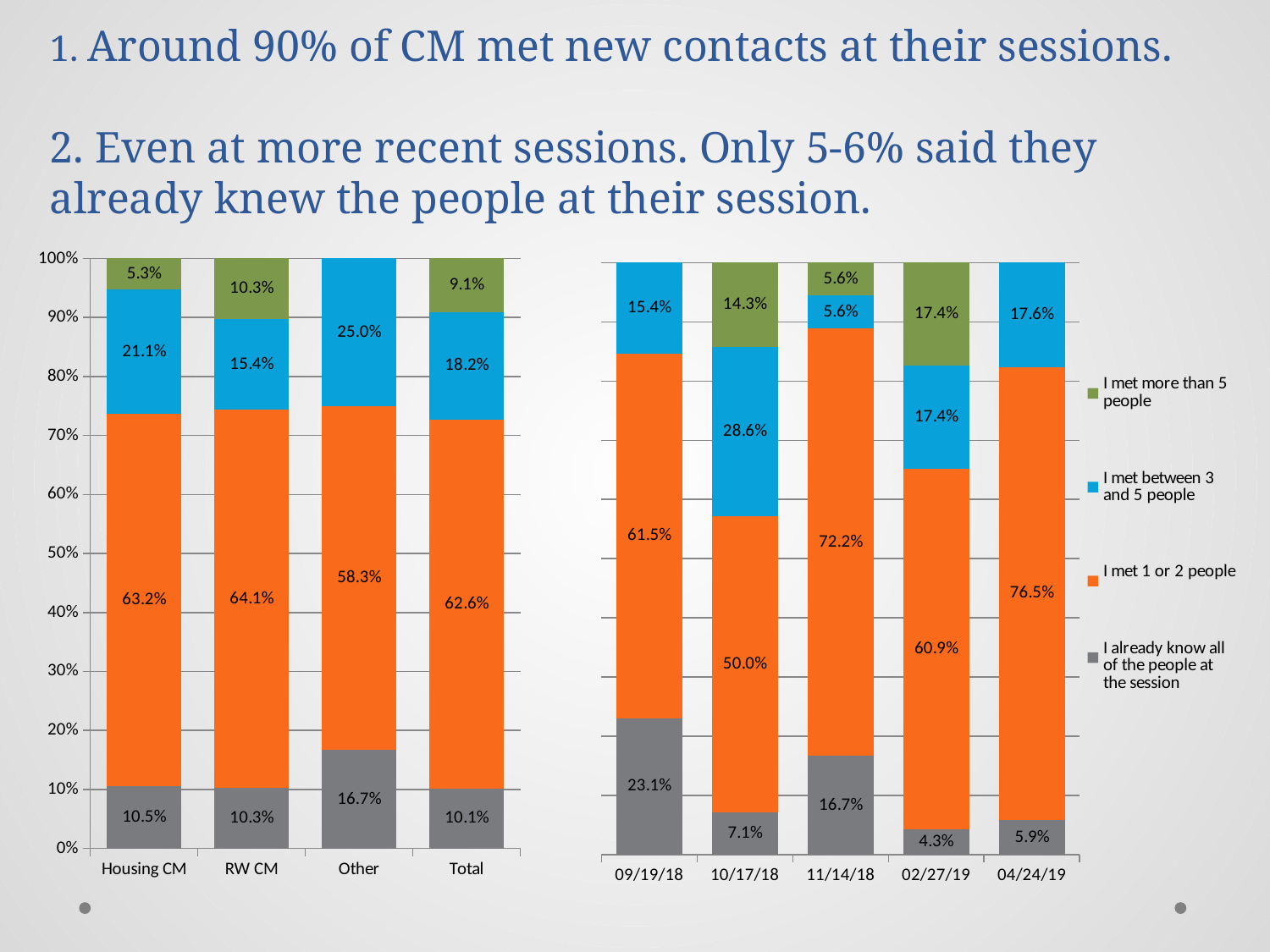
What type of chart is the left chart? Stacked bar chart In the right chart, what percentage at the 10/17/18 session said they met between 3 and 5 people? 28.6% In the left chart, which category has the highest share for 'I already know all of the people at the session'? Other In the left chart, what is the difference between the 'I met between 3 and 5 people' shares for Other and RW CM? 9.6% How many series does the legend list? 4 In the right chart, what is the combined share of 'I met between 3 and 5 people' and 'I met more than 5 people' on 02/27/19? 34.8% Which legend entry is shown in orange? I met 1 or 2 people In the right chart, which is larger: the 'I met 1 or 2 people' share on 11/14/18 or on 02/27/19? 11/14/18 In the right chart, what percentage at the 04/24/19 session said they met 1 or 2 people? 76.5% In the right chart, which session date has the lowest share for 'I already know all of the people at the session'? 02/27/19 In the left chart, what percentage of Housing CM said they met 1 or 2 people? 63.2% How many session dates are shown on the x axis of the right chart? 5